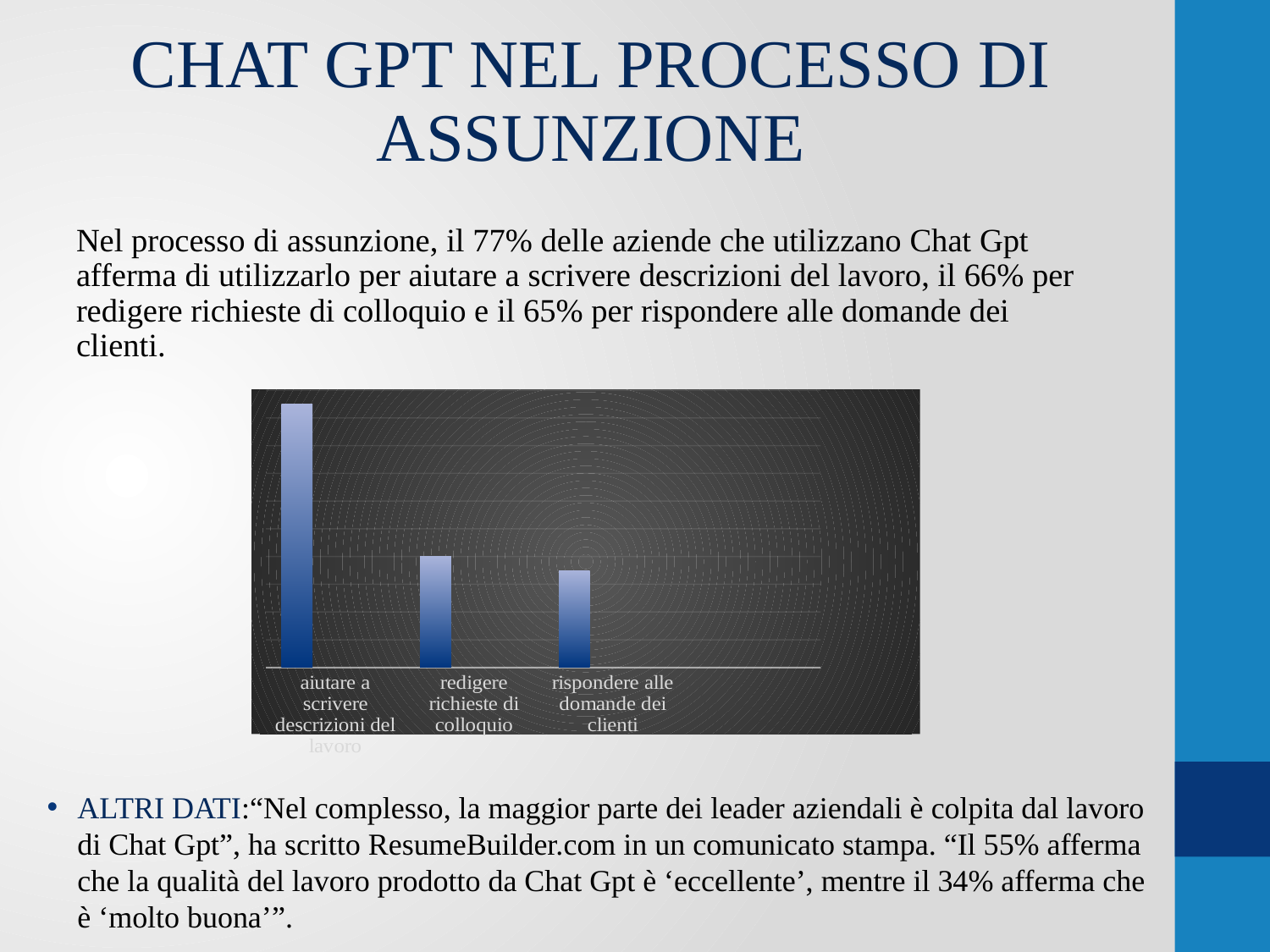
Which bar is taller: 'aiutare a scrivere descrizioni del lavoro' or 'rispondere alle domande dei clienti'? aiutare a scrivere descrizioni del lavoro Which category has the tallest bar in the chart? aiutare a scrivere descrizioni del lavoro What is the label of the first (leftmost) category on the x axis? aiutare a scrivere descrizioni del lavoro Which category has the shortest bar in the chart? rispondere alle domande dei clienti Do the bar heights rise or fall from left to right across the chart? fall What colour are the bars in the chart? blue What kind of chart is shown on the slide? bar chart Which bar is taller: 'aiutare a scrivere descrizioni del lavoro' or 'redigere richieste di colloquio'? aiutare a scrivere descrizioni del lavoro How many categories (bars) does the chart show? 3